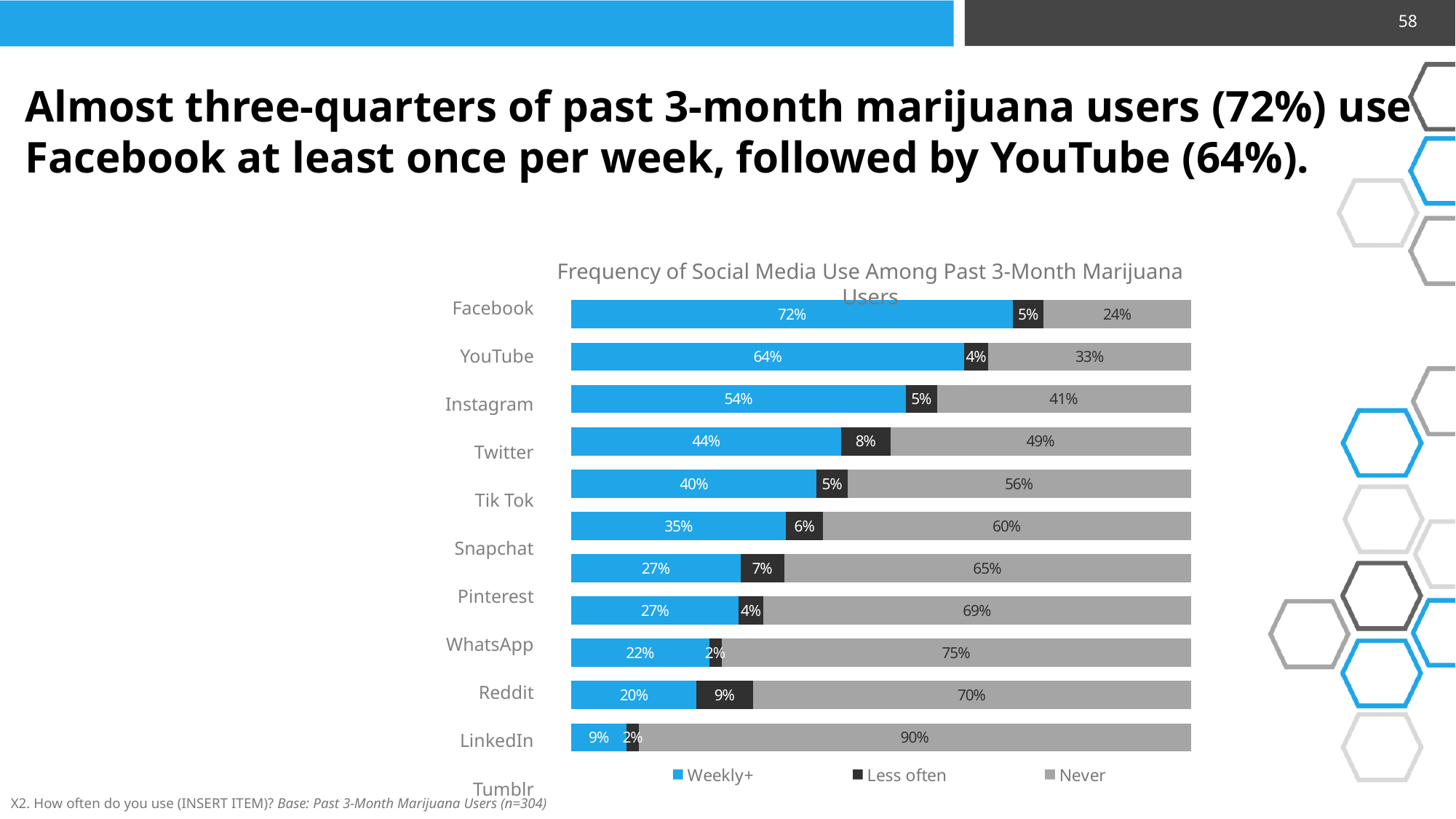
What is the Weekly+ value for Instagram? 54% Which colour represents the Weekly+ series in the legend? Blue What percentage of past 3-month marijuana users use Facebook Weekly+? 72% Which has a larger Never share, Instagram or YouTube? Instagram Which platform has the highest Weekly+ share? Facebook Do the Weekly+ values increase or decrease going from the top bar to the bottom bar? Decrease What is the Less often value for Facebook? 5% What kind of chart is shown on the slide? Stacked bar chart What is the Never value for YouTube? 33% How many series does the legend list? 3 What is the difference between the Weekly+ values for Facebook and YouTube? 8 percentage points What is the total of the three segments in the Instagram bar? 100%